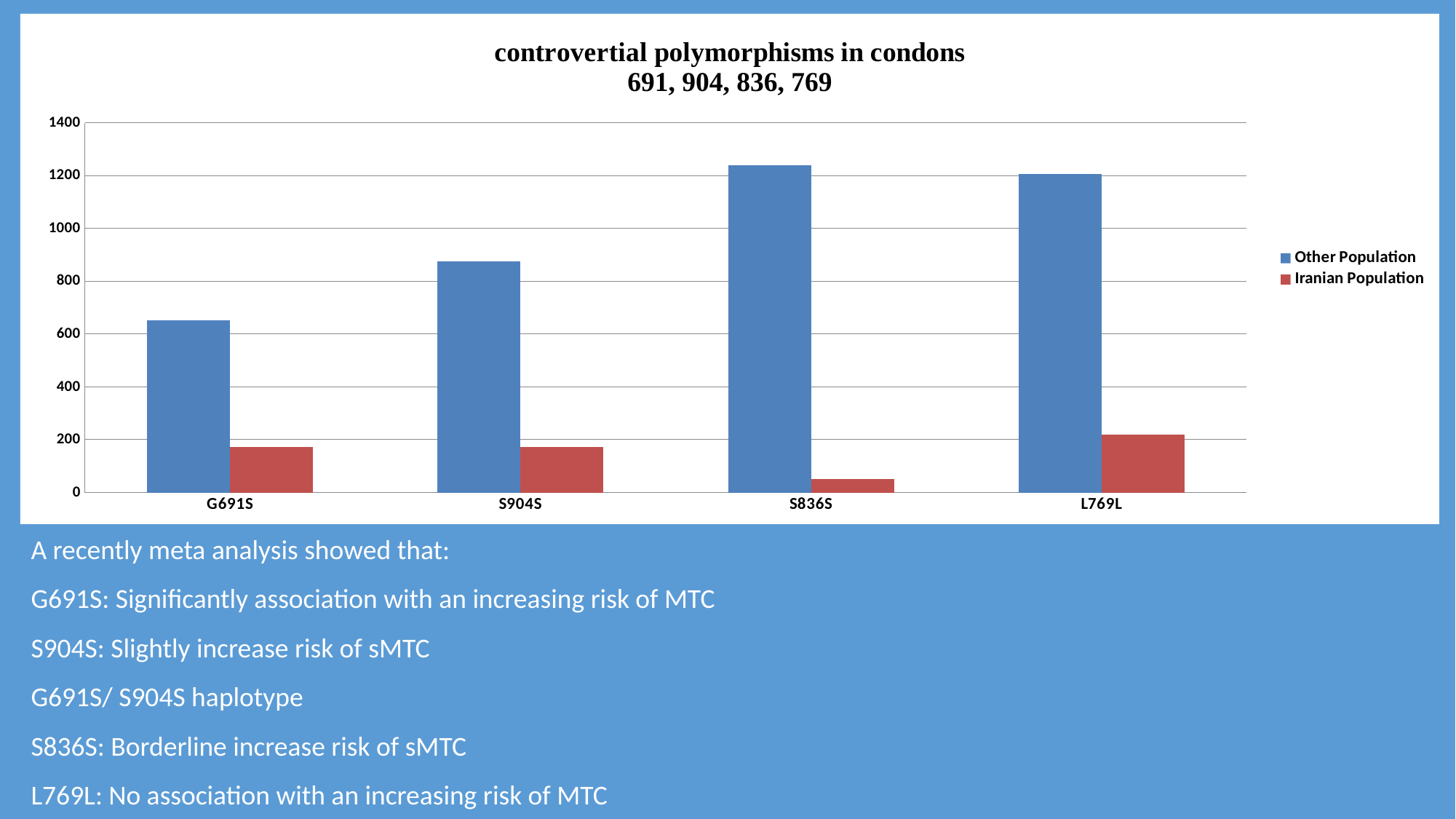
Which category has the highest Iranian Population value? L769L Which is larger for L769L: the Other Population value or the Iranian Population value? Other Population Which is larger: the Other Population value for S904S or the Other Population value for G691S? S904S Is the Other Population value for G691S greater or less than 800? less How many series does the chart's legend list? 2 Is the Iranian Population value for S836S greater or less than 200? less Which category has the lowest Other Population value? G691S Is the Other Population value for S836S greater or less than 1200? greater How many categories are shown on the x axis of the chart? 4 Which series is shown in red in the chart? Iranian Population What kind of chart is shown on the slide? bar chart Which category has the lowest Iranian Population value? S836S